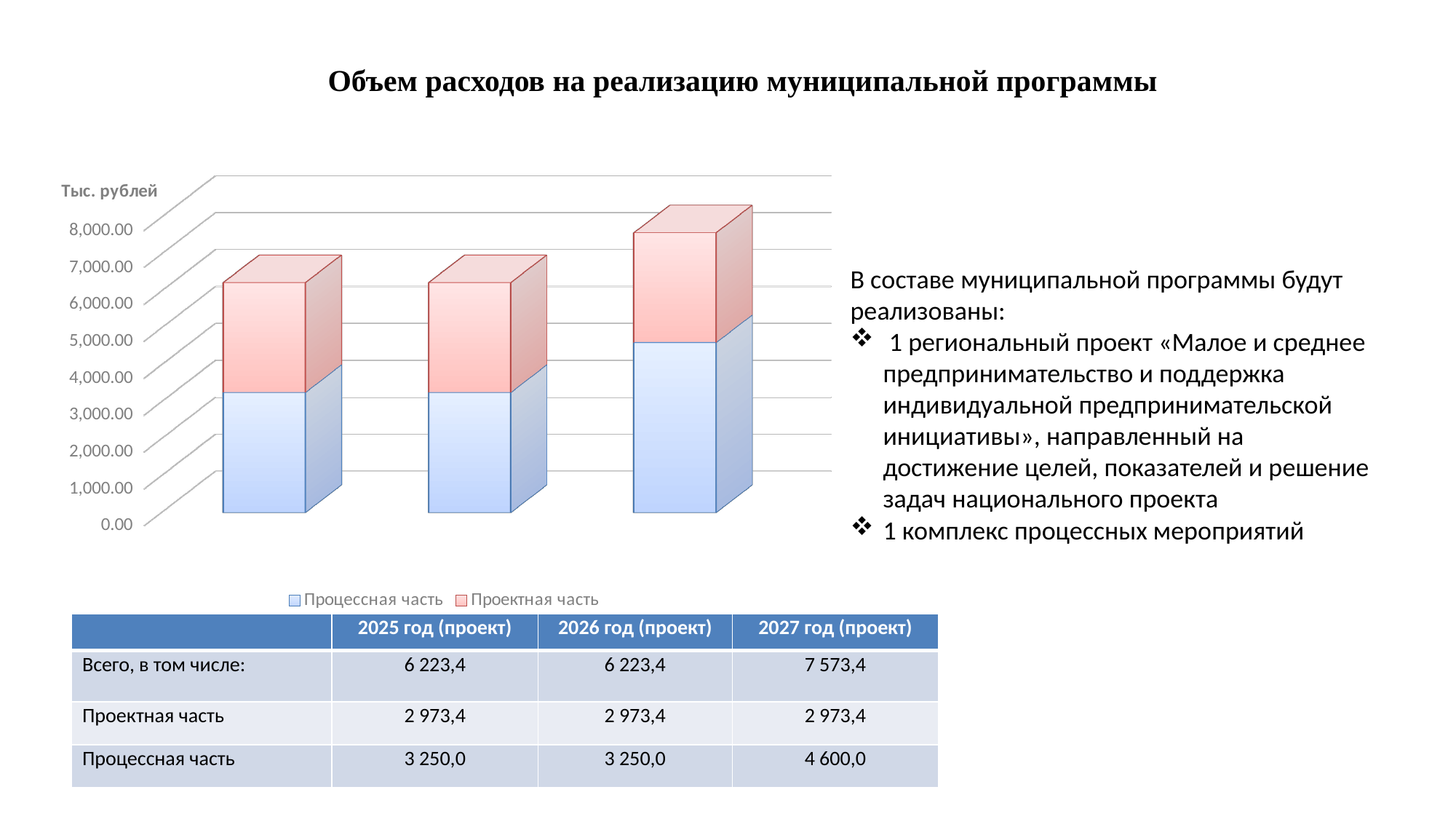
According to the table under the chart, what is the value of Процессная часть for 2027 год (проект)? 4 600,0 What are the two series named in the chart legend? Процессная часть, Проектная часть What unit label is shown at the top of the vertical axis? Тыс. рублей What kind of chart is shown on the slide? bar chart Which bar has the largest total: the leftmost, middle or rightmost? rightmost How many stacked bars are plotted in the chart? 3 Is the total height of the rightmost bar greater or less than 7,000.00? greater Is the blue (Процессная часть) segment of the rightmost bar greater or less than 4,000.00? greater According to the table under the chart, what is the difference between the total (Всего) for 2027 год (проект) and for 2025 год (проект)? 1 350,0 Is the total height of the leftmost bar greater or less than 7,000.00? less Do the bar totals rise or fall from the leftmost bar to the rightmost bar? rise How many series does the chart legend list? 2